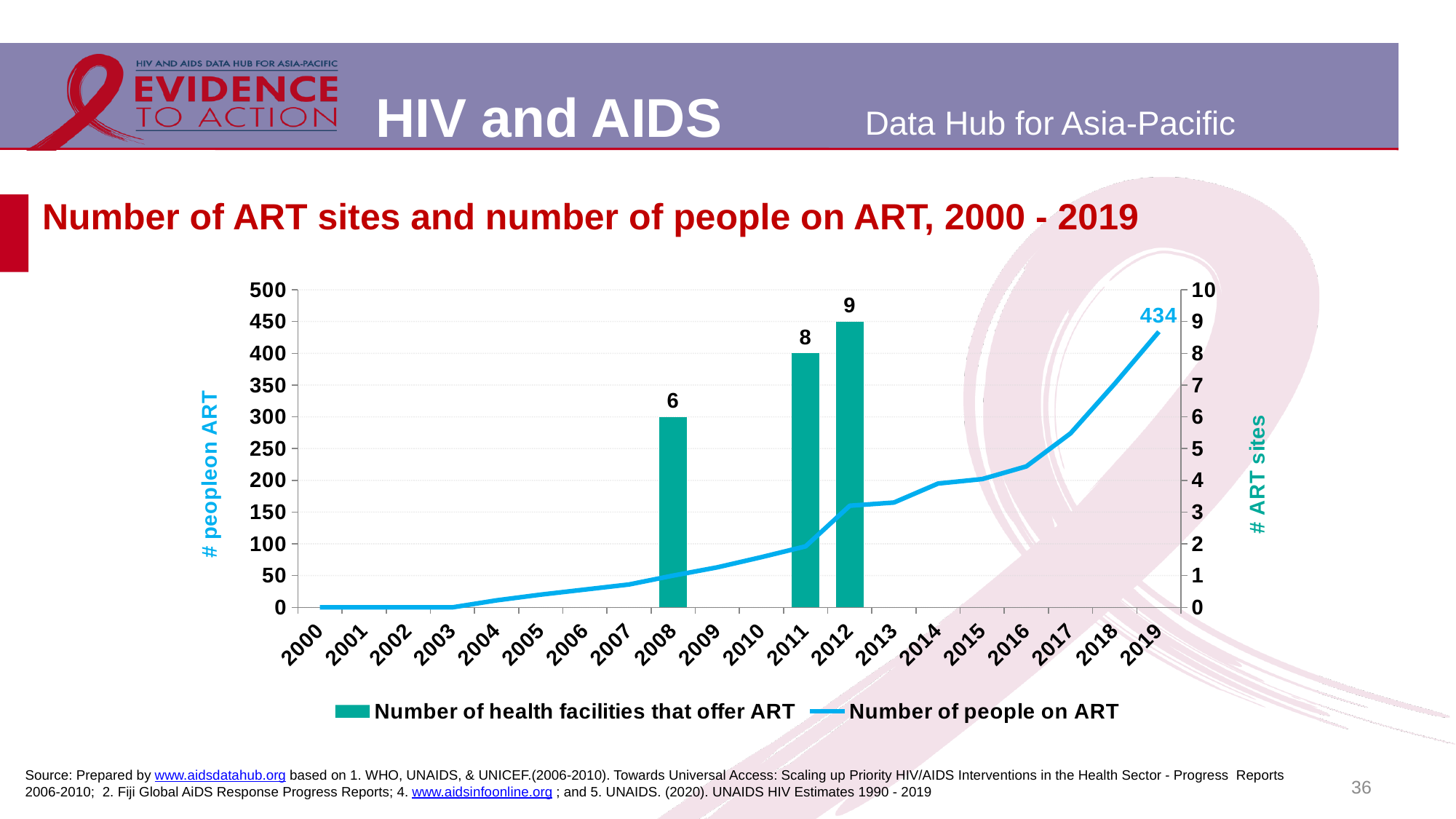
What is the difference between the number of health facilities that offer ART in 2012 and in 2008? 3 What is the number of people on ART in 2019? 434 How many years are shown on the x axis? 20 What is the number of health facilities that offer ART in 2008? 6 Among the years with a labelled bar, which year has the lowest number of health facilities that offer ART? 2008 How many series does the legend list? 2 In which year is the number of health facilities that offer ART highest? 2012 Does the number of people on ART rise or fall from 2000 to 2019? rise Which is larger: the number of health facilities that offer ART in 2011 or in 2012? 2012 What is the number of health facilities that offer ART in 2012? 9 What is the number of health facilities that offer ART in 2011? 8 Is the number of people on ART in 2016 greater or less than 300? less